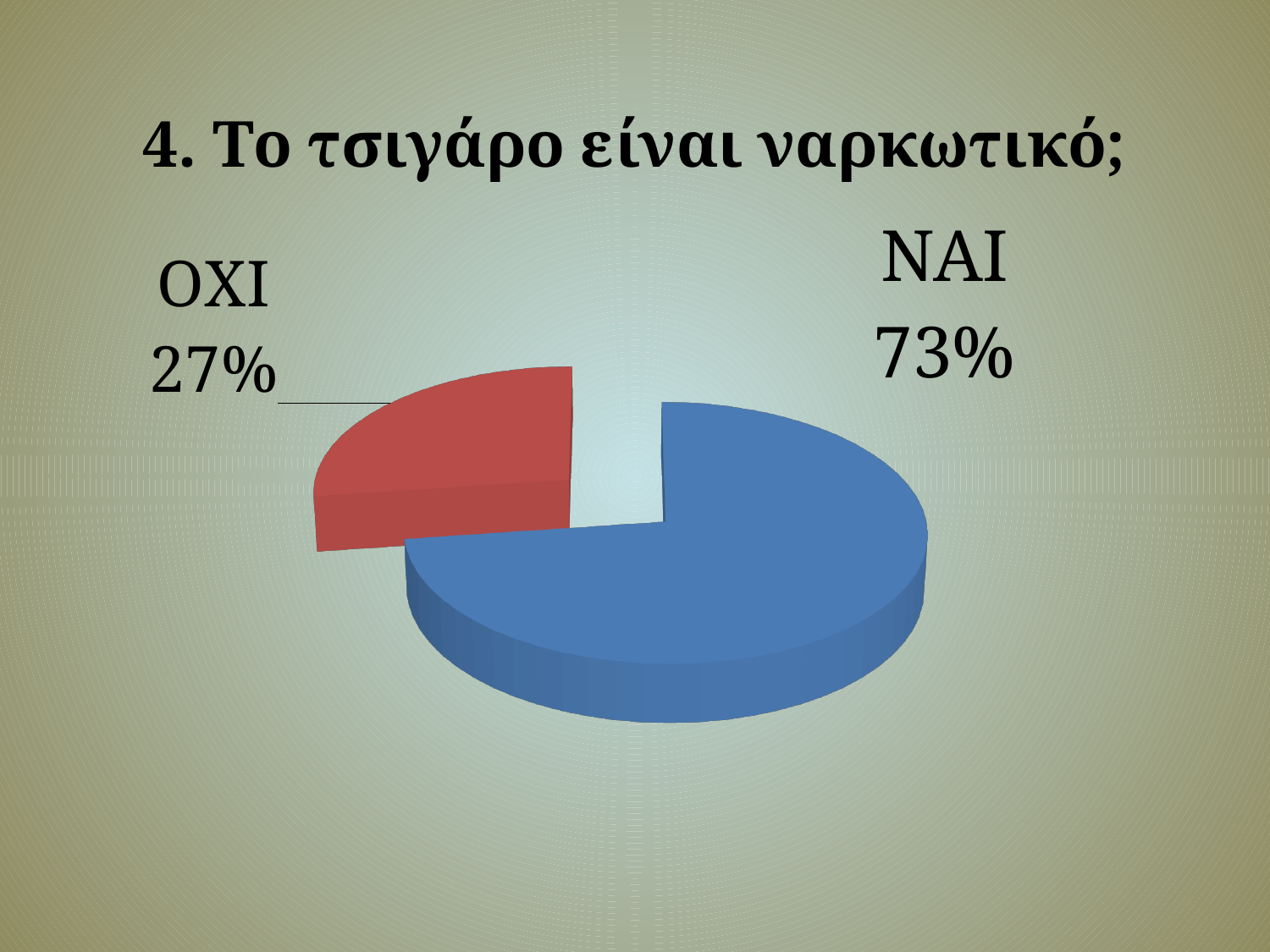
What percentage of the pie is labelled ΟΧΙ? 27% What is the title of the slide above the chart? 4. Το τσιγάρο είναι ναρκωτικό; Which is larger, the ΝΑΙ slice or the ΟΧΙ slice? ΝΑΙ Which slice is the smallest? ΟΧΙ What kind of chart is shown on the slide? pie chart How many slices does the pie chart have? 2 Which slice is the largest? ΝΑΙ What colour is the ΟΧΙ slice? red What share of the pie does the ΝΑΙ slice represent? 73% What is the difference in percentage points between the ΝΑΙ and ΟΧΙ slices? 46 What percentage of the pie is labelled ΝΑΙ? 73%